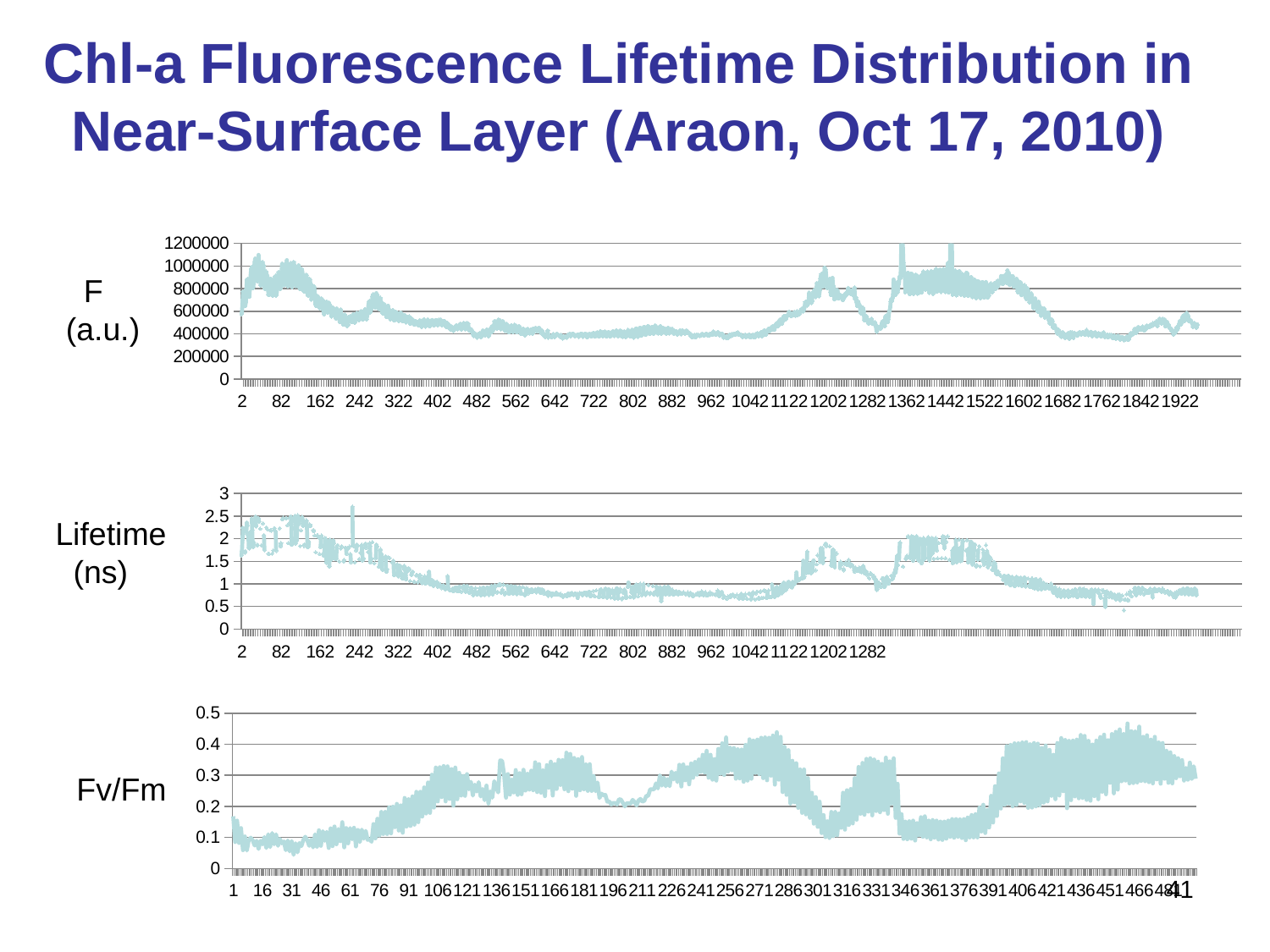
In the top chart (F (a.u.)), do the values rise or fall from x = 82 to x = 722? fall In the bottom chart (Fv/Fm), is the value at x = 16 greater or less than 0.2? less How many charts are shown on the slide? 3 In the middle chart (Lifetime (ns)), is the value at x = 722 greater or less than 1.5? less In the top chart (F (a.u.)), is the value at x = 722 greater or less than 600000? less In the bottom chart (Fv/Fm), which is larger, the value at x = 256 or the value at x = 361? x = 256 In the middle chart (Lifetime (ns)), do the values rise or fall from x = 2 to x = 482? fall What kind of chart is the top chart labelled F (a.u.)? line chart In the top chart (F (a.u.)), which is larger, the value at x = 1442 or the value at x = 722? x = 1442